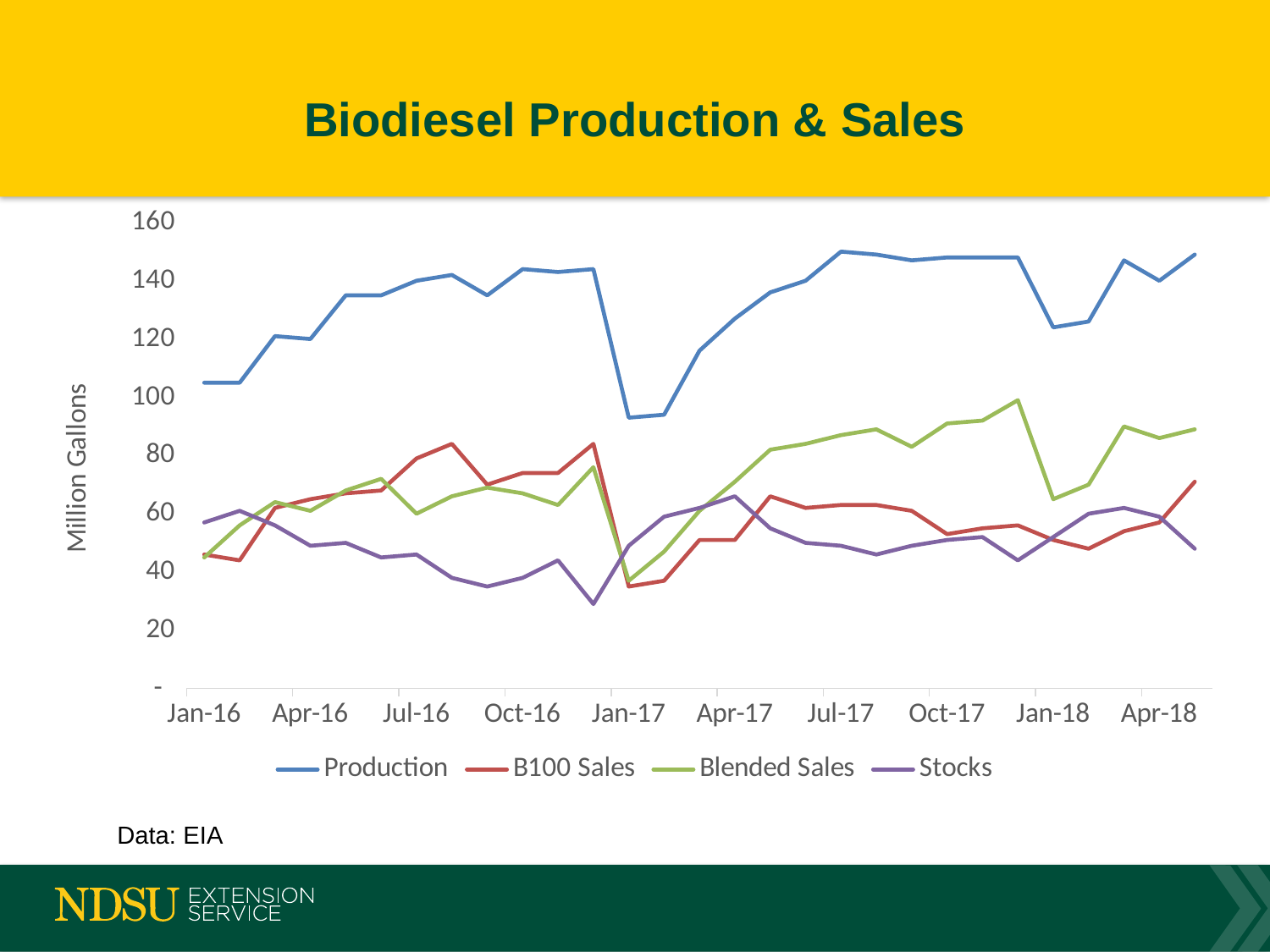
How many series does the legend list? 4 What is the label on the vertical axis? Million Gallons How many date labels are shown on the x axis? 10 Which series reaches the lowest value on the chart? Stocks Does Production rise or fall between Oct-16 and Jan-17? Fall Which series has the highest values across the whole chart? Production At Oct-17, which is larger: Blended Sales or B100 Sales? Blended Sales What is the title of the chart? Biodiesel Production & Sales Is the value for Production at Jul-17 greater or less than 120? greater What kind of chart is shown on the slide? Line chart Is the value for Production at Jan-17 greater or less than 100? less Is the value for Stocks at Jan-16 greater or less than 80? less